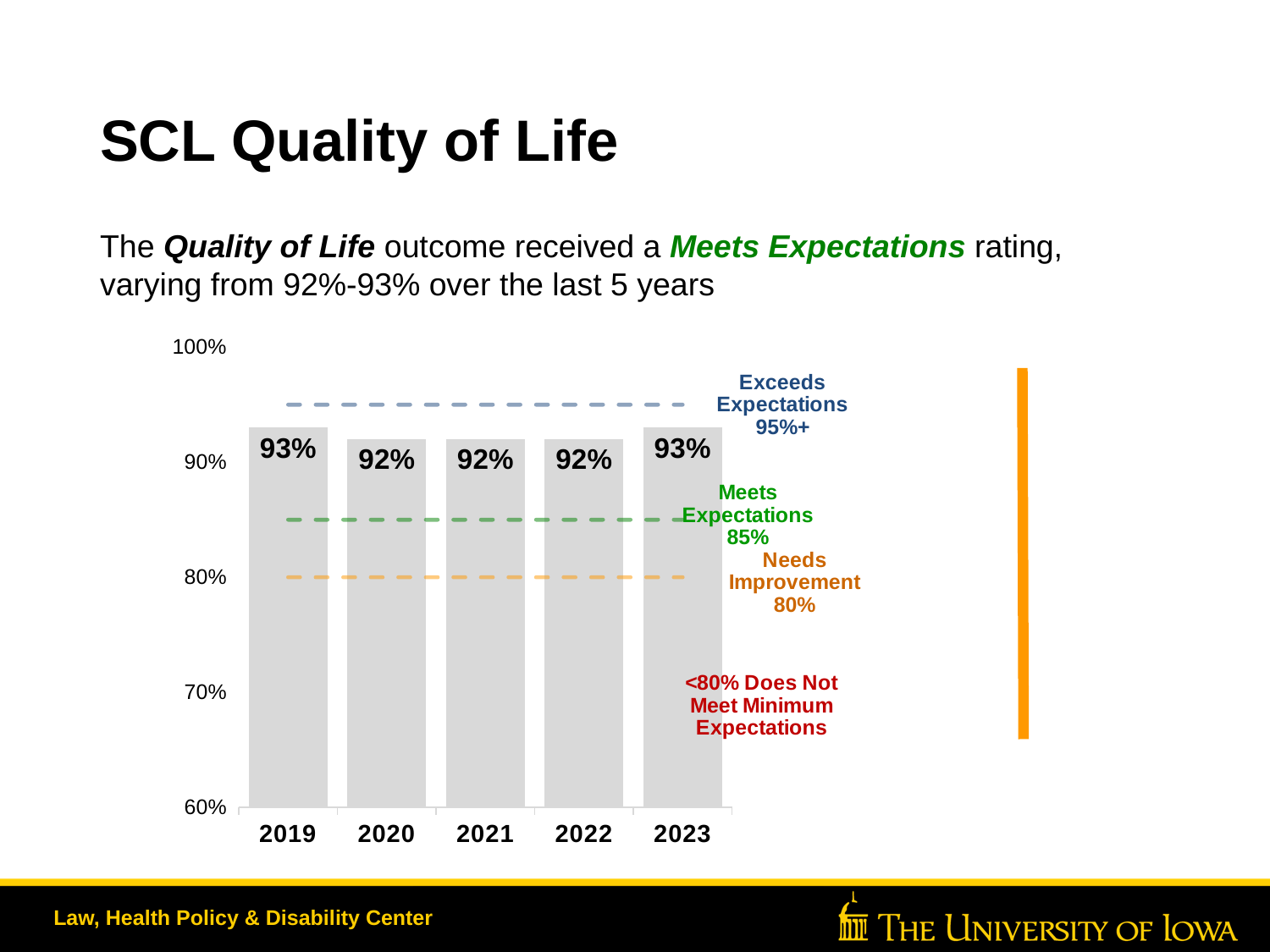
Is the value for 2020 greater or less than 90%? greater What is the value for 2023? 93% How many years are shown on the x axis? 5 What is the lowest value shown on the y axis? 60% Which is larger, the value for 2019 or the value for 2022? 2019 What is the difference between the values for 2019 and 2020? 1% What threshold is labelled as Meets Expectations on the chart? 85% What is the value for 2021? 92% What is the value for 2022? 92% What is the value for 2019? 93% What kind of chart is this? bar chart Is the value for 2023 greater or less than 95%? less